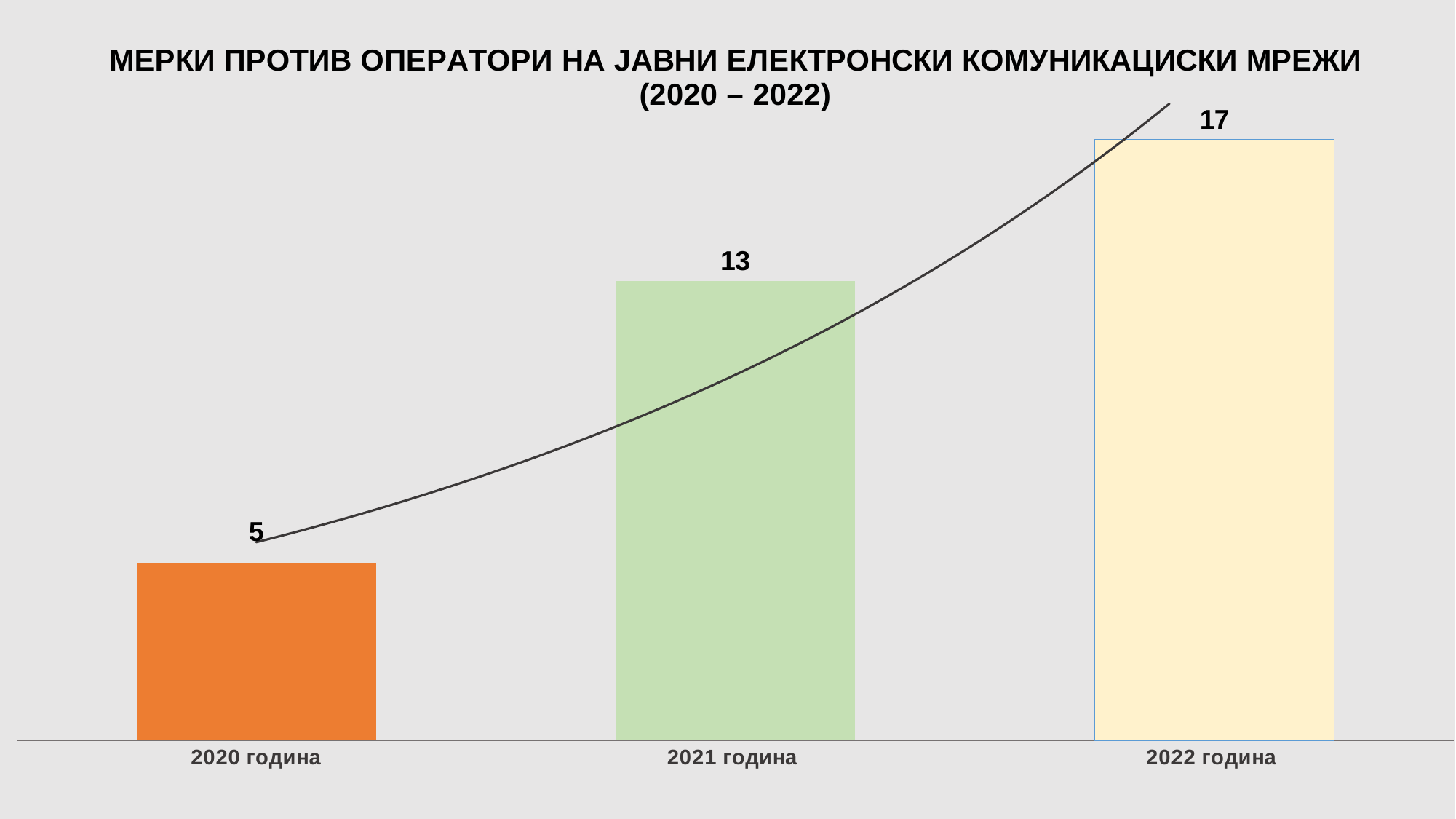
Which year has the highest value? 2022 година What is the value for 2020 година? 5 What is the difference between the values for 2022 година and 2020 година? 12 How many years are shown on the chart? 3 What is the value for 2022 година? 17 What is the value for 2021 година? 13 Do the values rise or fall from 2020 to 2022? rise What is the difference between the values for 2021 година and 2020 година? 8 Which year has the lowest value? 2020 година What colour is the bar for 2020 година? orange Which is larger, the value for 2021 година or the value for 2022 година? 2022 година What kind of chart is this? bar chart